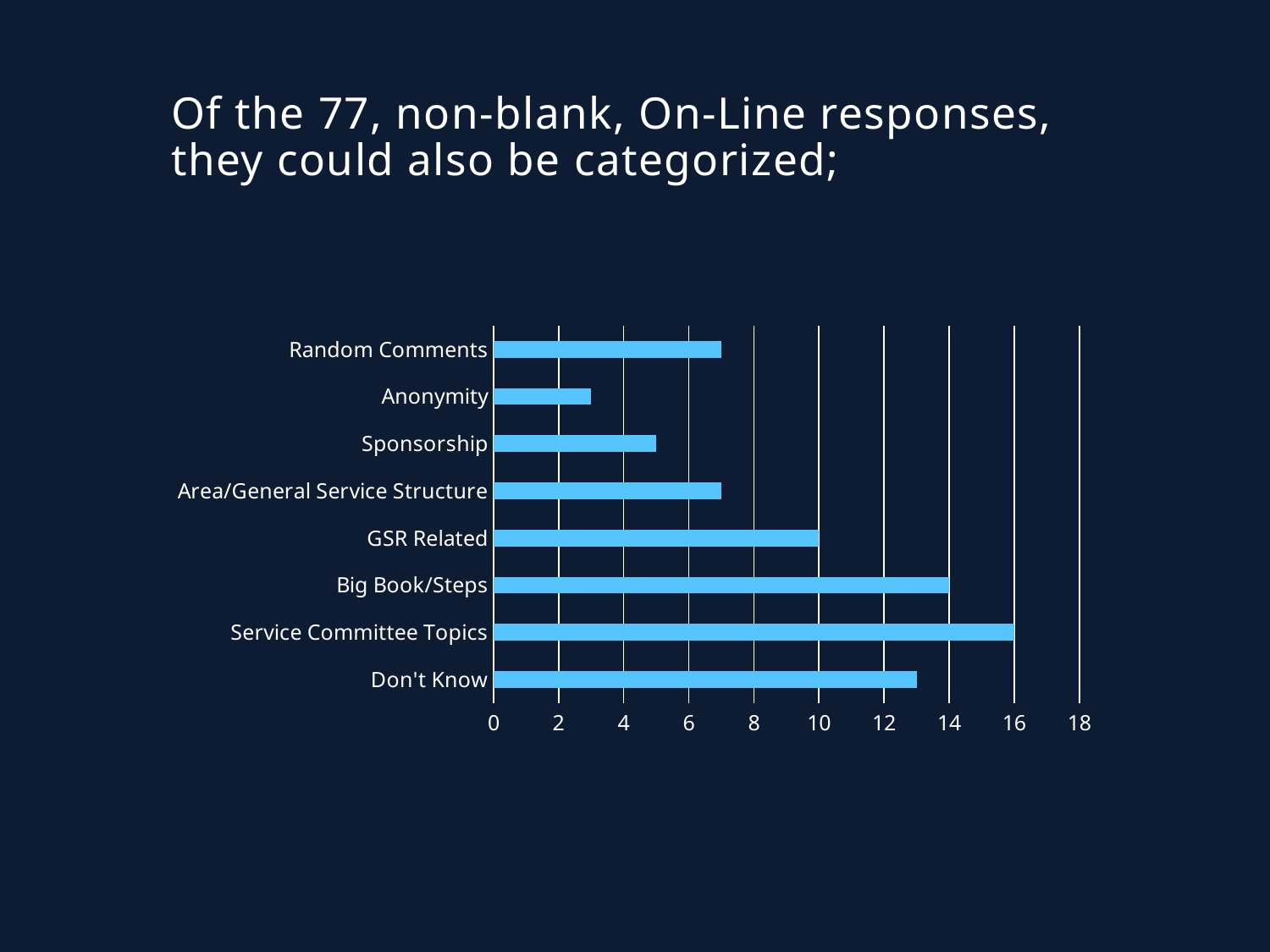
What is the value for Big Book/Steps? 14 Is the value for Anonymity greater or less than 4? less What is the difference between the values for Service Committee Topics and Big Book/Steps? 2 Is the value for Don't Know greater or less than 12? greater What kind of chart is shown on the slide? bar chart How many categories are plotted in the chart? 8 Which category has the lowest value? Anonymity Is the value for Random Comments greater or less than 6? greater Which category has the highest value? Service Committee Topics What is the value for GSR Related? 10 What is the value for Service Committee Topics? 16 Which is larger, the value for Big Book/Steps or the value for GSR Related? Big Book/Steps